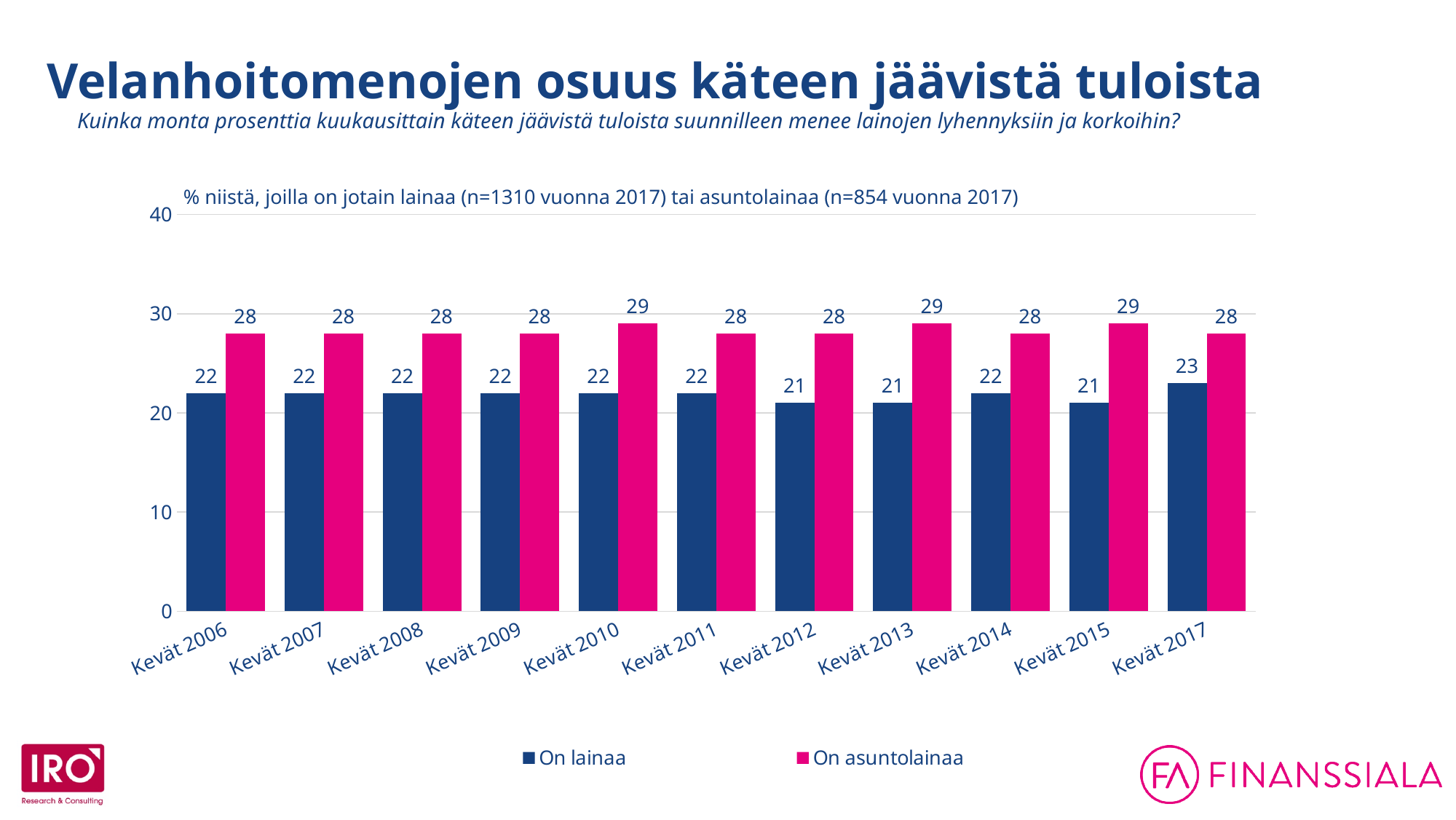
Is the value for "On asuntolainaa" in Kevät 2011 greater or less than 20? greater How many categories are shown on the x axis? 11 Which is larger in Kevät 2015: "On lainaa" or "On asuntolainaa"? On asuntolainaa What is the difference between "On asuntolainaa" and "On lainaa" in Kevät 2017? 5 What is the value for "On asuntolainaa" in Kevät 2006? 28 What is the difference between "On asuntolainaa" and "On lainaa" in Kevät 2013? 8 Which category has the highest value for "On lainaa"? Kevät 2017 What is the value for "On lainaa" in Kevät 2012? 21 What is the value for "On asuntolainaa" in Kevät 2010? 29 What kind of chart is shown on the slide? Bar chart What is the value for "On lainaa" in Kevät 2017? 23 How many series does the legend list? 2